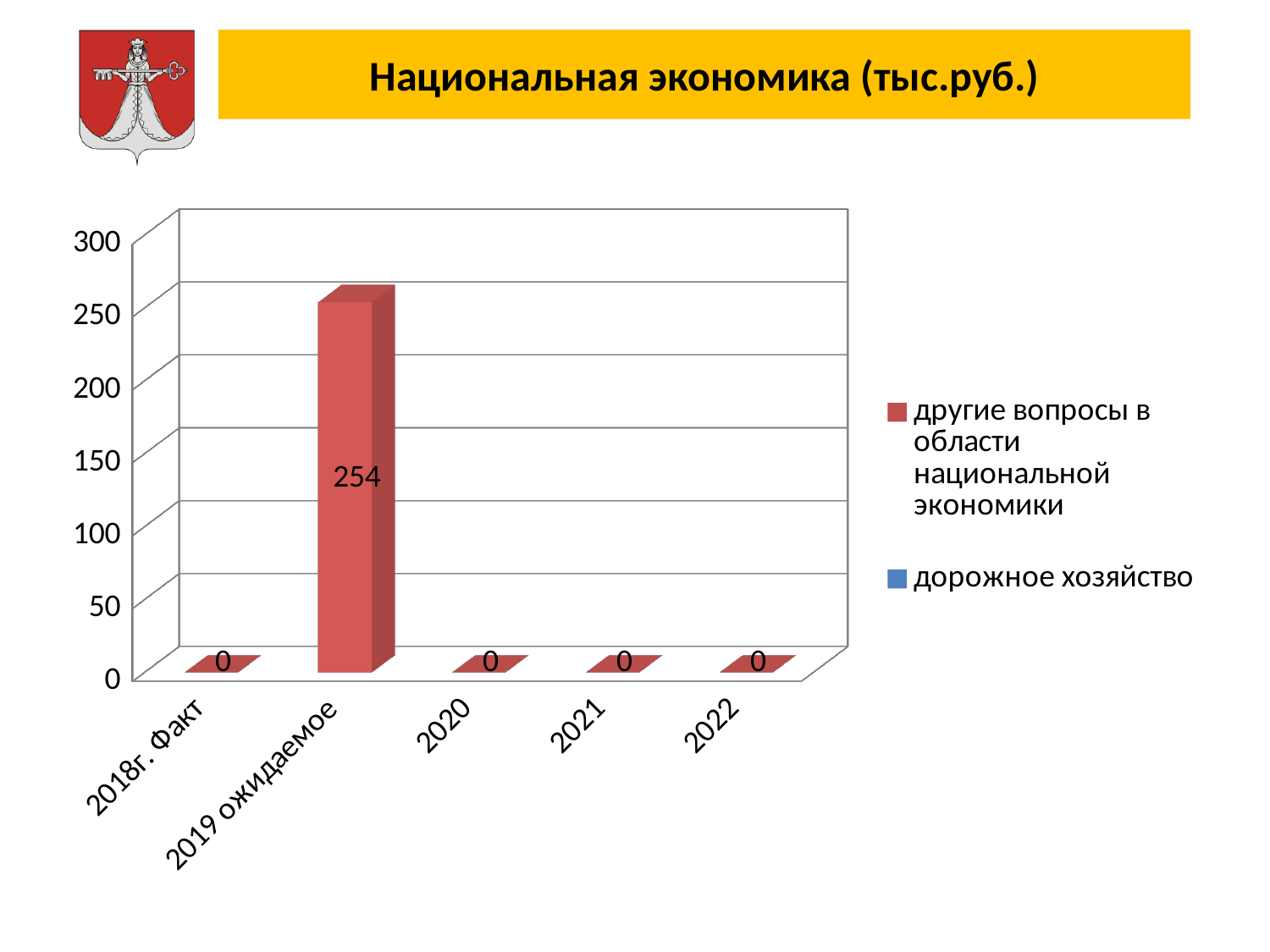
What is the value for 2018г. Факт for the series 'другие вопросы в области национальной экономики'? 0 How many categories are shown on the x axis? 5 What is the value for 2022 for the series 'другие вопросы в области национальной экономики'? 0 What is the value for 2019 ожидаемое for the series 'другие вопросы в области национальной экономики'? 254 How many series does the legend list? 2 Which category has the highest value for 'другие вопросы в области национальной экономики'? 2019 ожидаемое What kind of chart is shown on the slide? bar chart Which is larger for 'другие вопросы в области национальной экономики': the value for 2019 ожидаемое or the value for 2021? 2019 ожидаемое Which series is shown in blue in the legend? дорожное хозяйство What is the difference between the 2019 ожидаемое value and the 2020 value for 'другие вопросы в области национальной экономики'? 254 Is the value for 2019 ожидаемое greater or less than 250? greater What is the title of the chart? Национальная экономика (тыс.руб.)